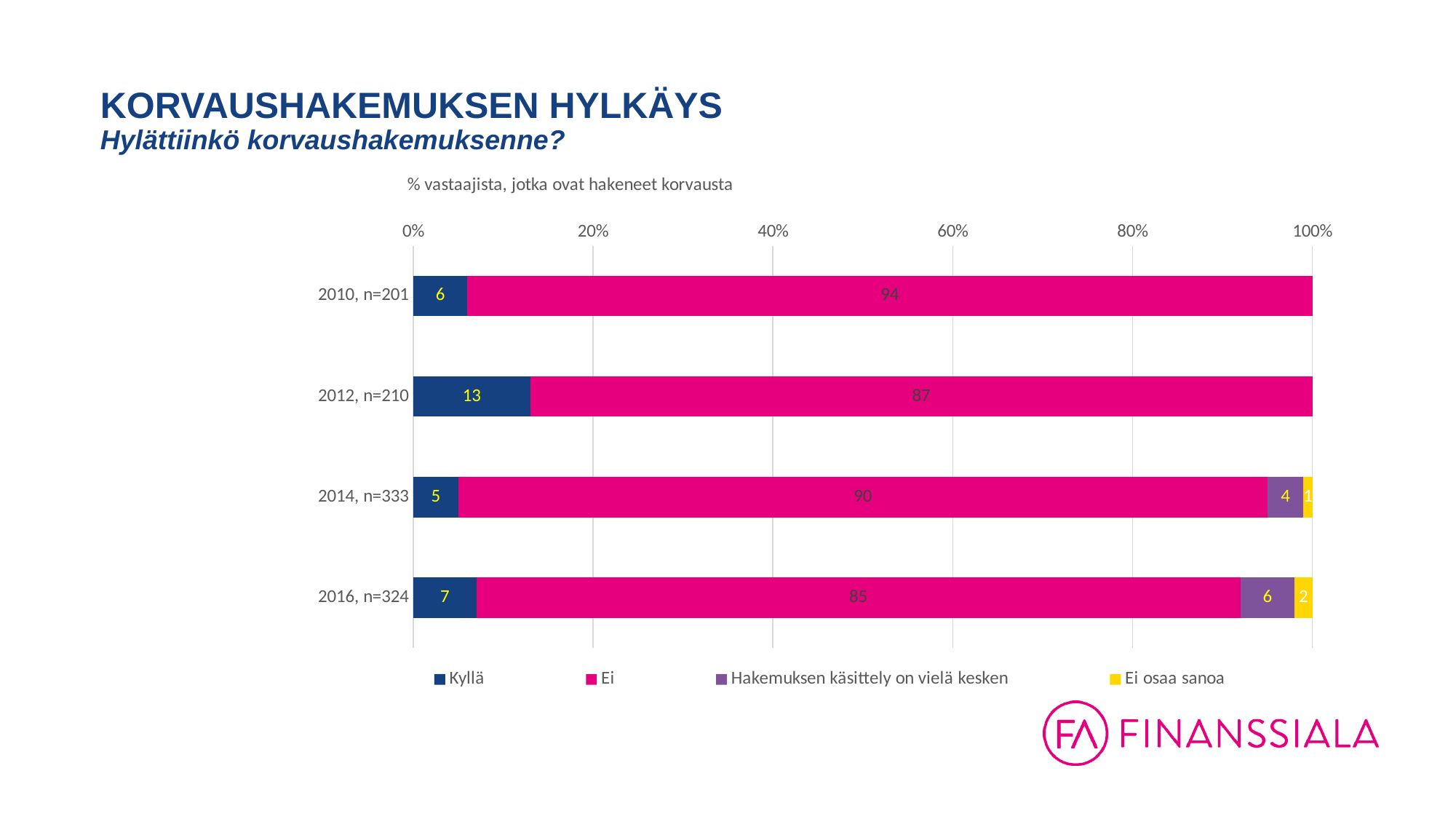
What kind of chart is shown on the slide? Stacked bar chart What is the value for "Kyllä" in the 2012, n=210 bar? 13 What is the value for "Ei" in the 2010, n=201 bar? 94 What is the total of the 2014, n=333 stacked bar? 100 What is the value for "Ei osaa sanoa" in the 2014, n=333 bar? 1 Which year has the highest value for "Kyllä"? 2012, n=210 What is the value for "Hakemuksen käsittely on vielä kesken" in the 2016, n=324 bar? 6 Which is larger: the "Kyllä" value for 2014, n=333 or for 2016, n=324? 2016, n=324 What is the difference between the "Ei" values for 2010, n=201 and 2016, n=324? 9 How many year categories are shown on the chart? 4 How many series does the legend list? 4 Which year has the lowest value for "Ei"? 2016, n=324